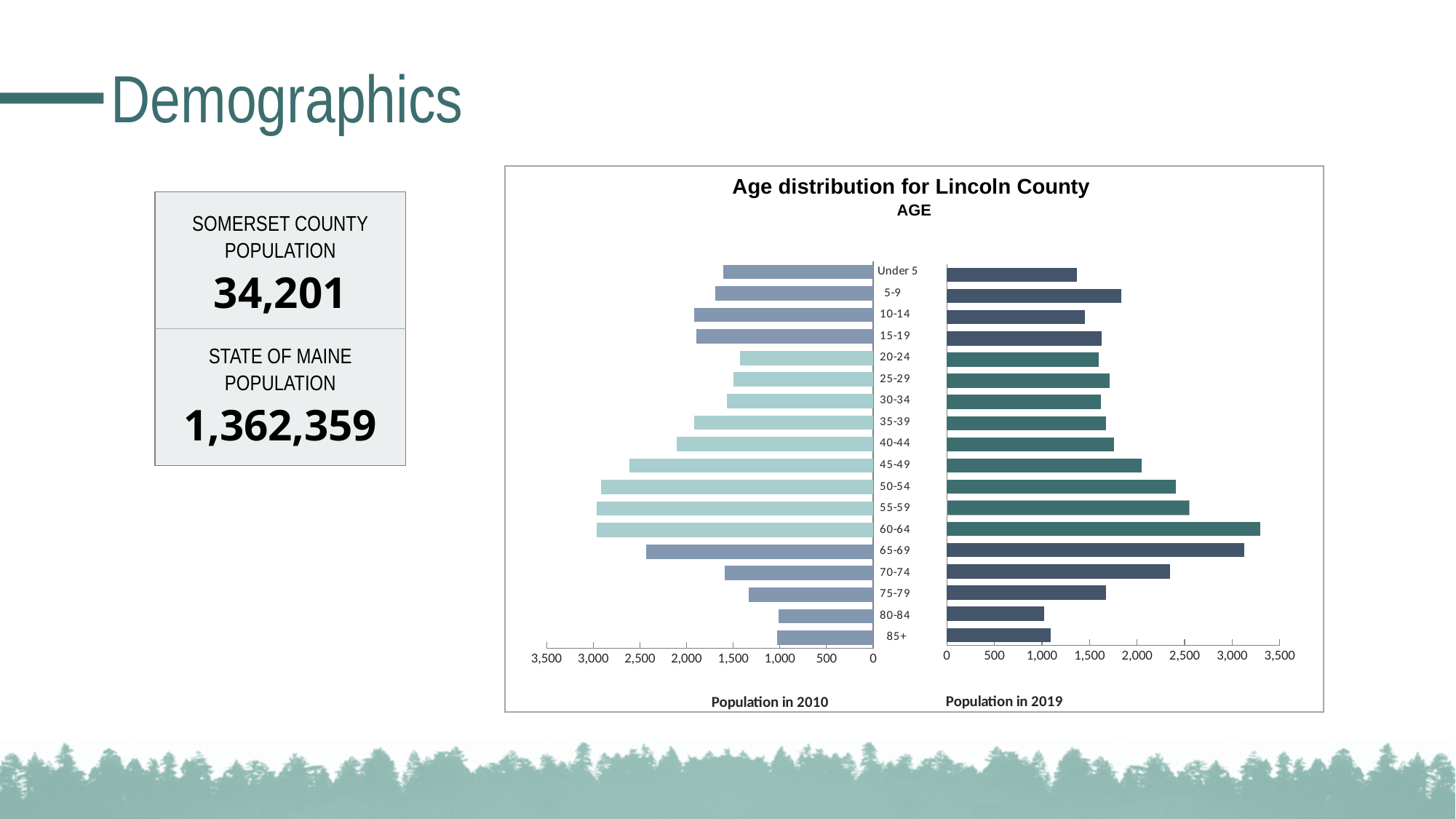
What kind of chart is shown on the slide? Bar chart In the Population in 2019 side, which is larger: the value for Under 5 or the value for 60-64? 60-64 In the Population in 2010 side, which is larger: the value for 20-24 or the value for 40-44? 40-44 Is the Population in 2010 value for the Under 5 age group greater or less than 2,000? less Is the Population in 2019 value for the 60-64 age group greater or less than 3,000? greater What is the title of the chart? Age distribution for Lincoln County Is the Population in 2019 value for the 65-69 age group greater or less than 2,500? greater In the Population in 2019 side of the chart, which age group has the highest value? 60-64 How many age groups are shown in the chart? 18 Which two years are compared in the chart? 2010 and 2019